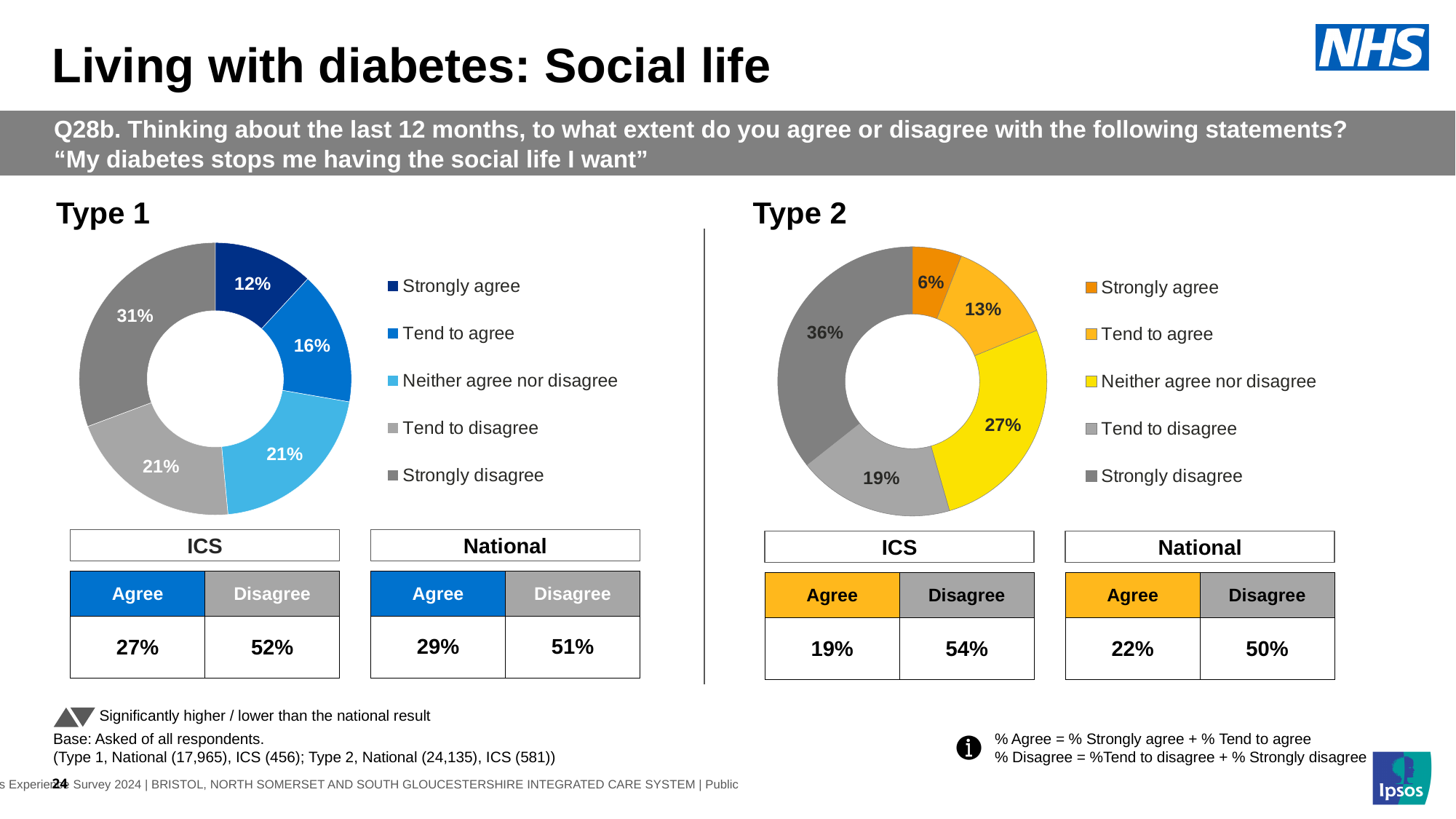
In the Type 1 chart, what percentage of respondents tend to agree? 16% What kind of chart is used for Type 2? Donut chart In the Type 2 chart, what percentage of respondents strongly disagree? 36% In the Type 2 chart, what is the difference in percentage points between Strongly disagree and Tend to disagree? 17 Which is larger: the Strongly agree share in the Type 1 chart or the Strongly agree share in the Type 2 chart? Type 1 In the Type 2 chart, what percentage of respondents neither agree nor disagree? 27% In the Type 1 chart, what percentage of respondents strongly agree? 12% In the Type 1 chart, which response category has the largest share? Strongly disagree How many response categories does the Type 1 chart show? 5 In the Type 2 chart, which response category has the smallest share? Strongly agree In the Type 2 chart, what colour is the Neither agree nor disagree segment? Yellow In the Type 1 chart, what is the difference in percentage points between Strongly disagree and Strongly agree? 19